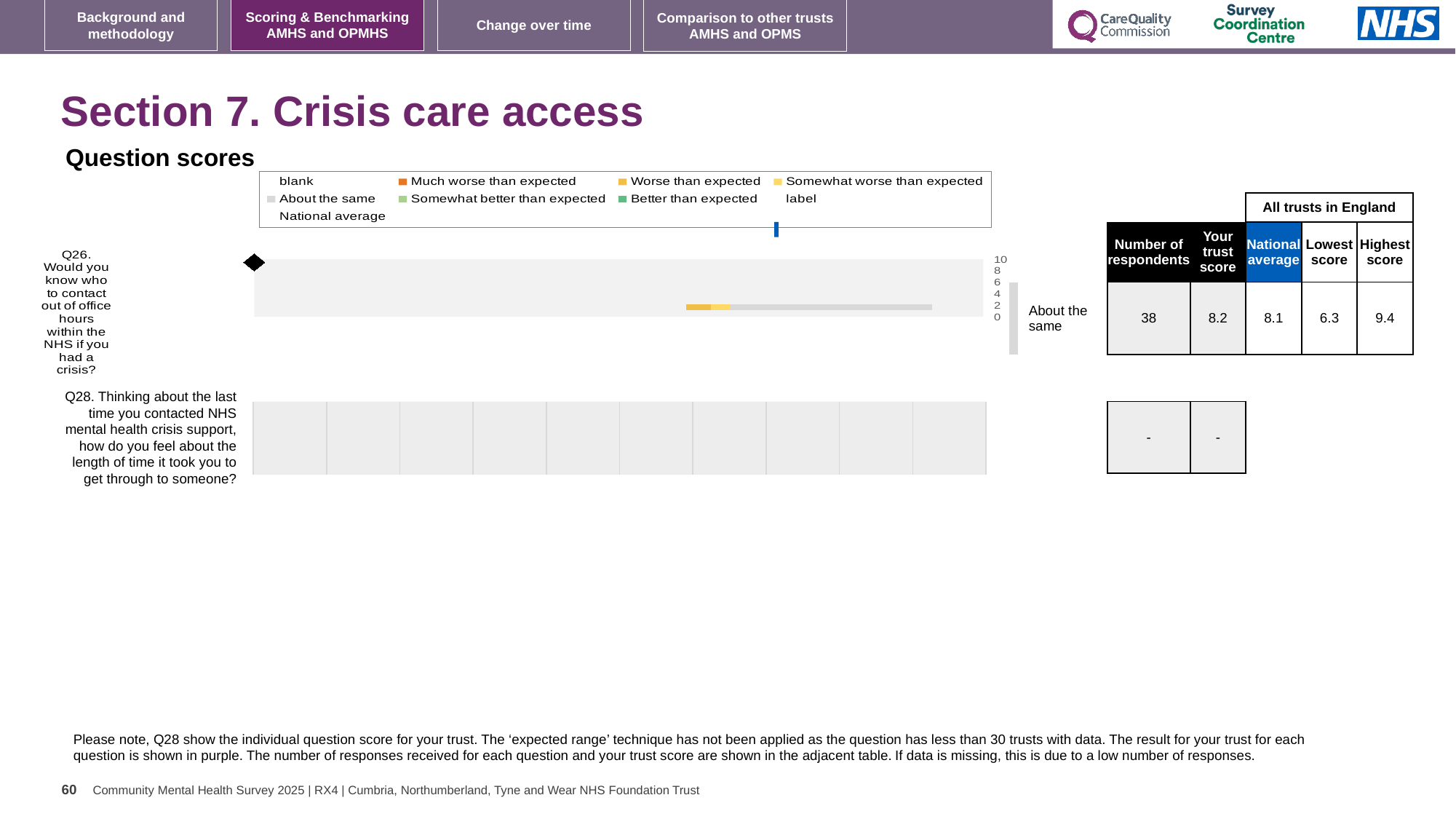
What is the national average score for Q26? 8.1 What is the trust score for Q26 (Would you know who to contact out of office hours within the NHS if you had a crisis?)? 8.2 What benchmark category label is shown beside the Q26 bar in the chart? About the same What is the number of respondents for Q26 in the table next to the chart? 38 What value is shown for the number of respondents for Q28 in the table? - What is the lowest score among all trusts in England for Q26? 6.3 What is the difference between the highest and lowest scores for Q26 across all trusts in England? 3.1 What is the highest score among all trusts in England for Q26? 9.4 How many questions are plotted in the Question scores chart? 2 By how much does the trust score for Q26 exceed the national average? 0.1 For Q26, which is larger: the trust score or the national average? Trust score What kind of chart is used to show the question scores on this slide? Bar chart